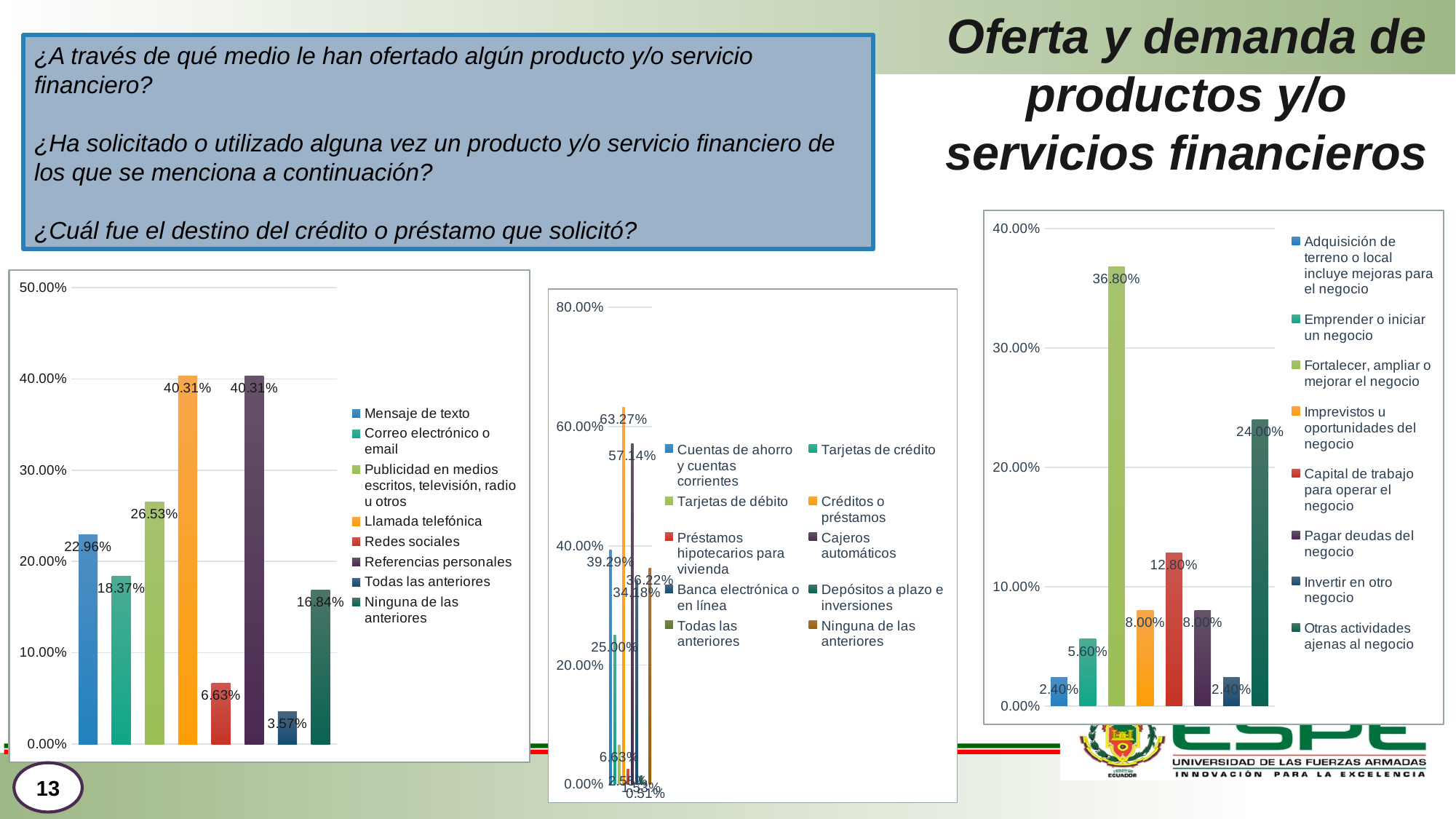
In the right chart, what is the value for Fortalecer, ampliar o mejorar el negocio? 36.80% In the left chart, what is the value for Redes sociales? 6.63% What type of chart is the right chart? Bar chart In the right chart, what is the difference between Otras actividades ajenas al negocio and Capital de trabajo para operar el negocio? 11.20% In the middle chart, how many series does the legend list? 10 In the left chart, what is the value for Llamada telefónica? 40.31% In the left chart, which category has the lowest value? Todas las anteriores In the middle chart, what is the value for Cajeros automáticos? 57.14% In the left chart, how many categories are plotted? 8 In the middle chart, which category has the highest value? Créditos o préstamos In the left chart, which is larger: Mensaje de texto or Ninguna de las anteriores? Mensaje de texto In the left chart, what is the difference between Publicidad en medios escritos, televisión, radio u otros and Correo electrónico o email? 8.16%